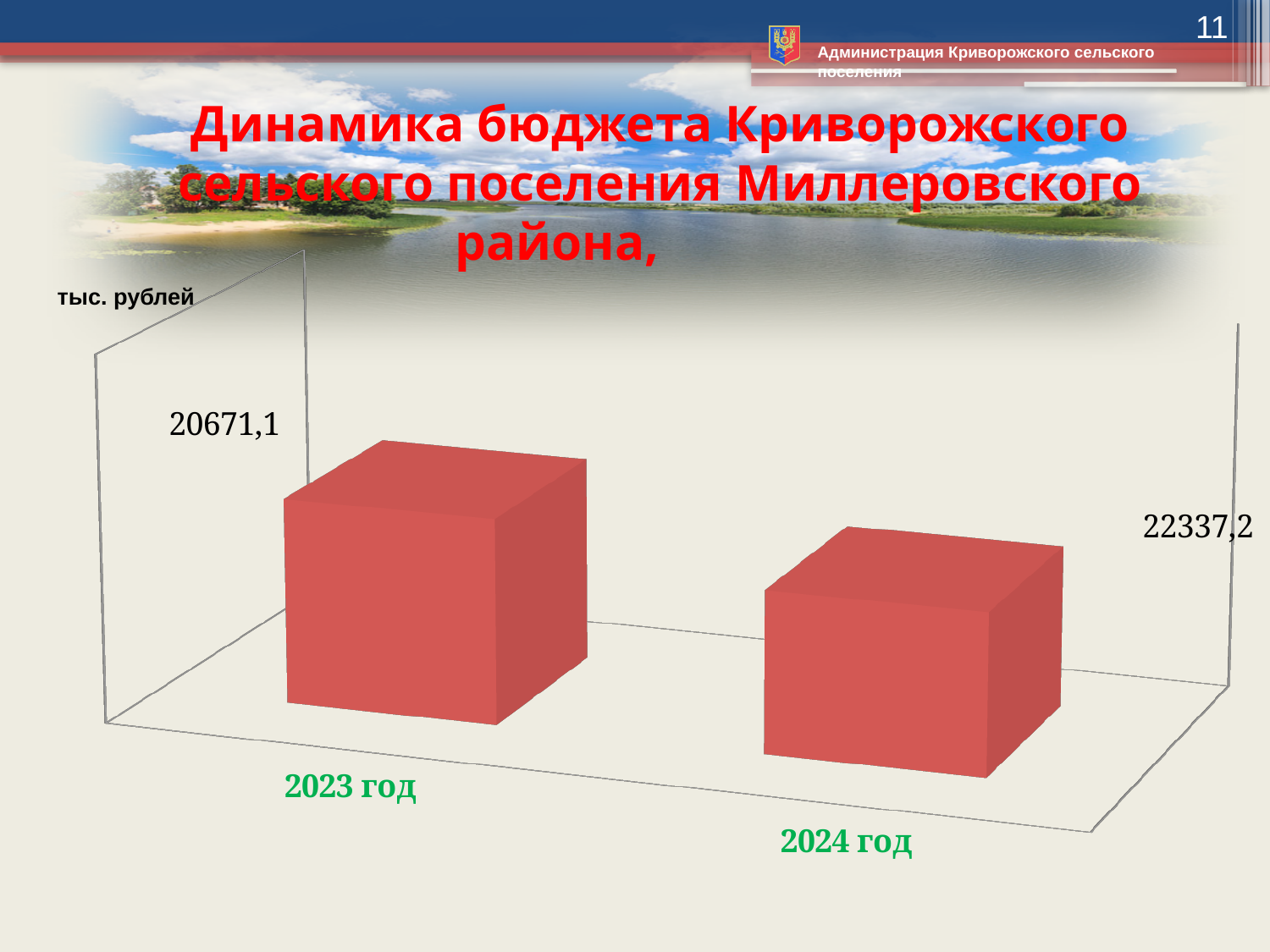
By how much does the 2024 год value exceed the 2023 год value? 1666,1 What is the budget value shown for 2023 год? 20671,1 What colour are the bars in the chart? red Which year has the lower budget value according to the data labels? 2023 год What type of chart is used on this slide? bar chart In what units are the chart values expressed? тыс. рублей How many years (categories) are shown in the chart? 2 What is the budget value shown for 2024 год? 22337,2 Which year has the higher budget value according to the data labels? 2024 год